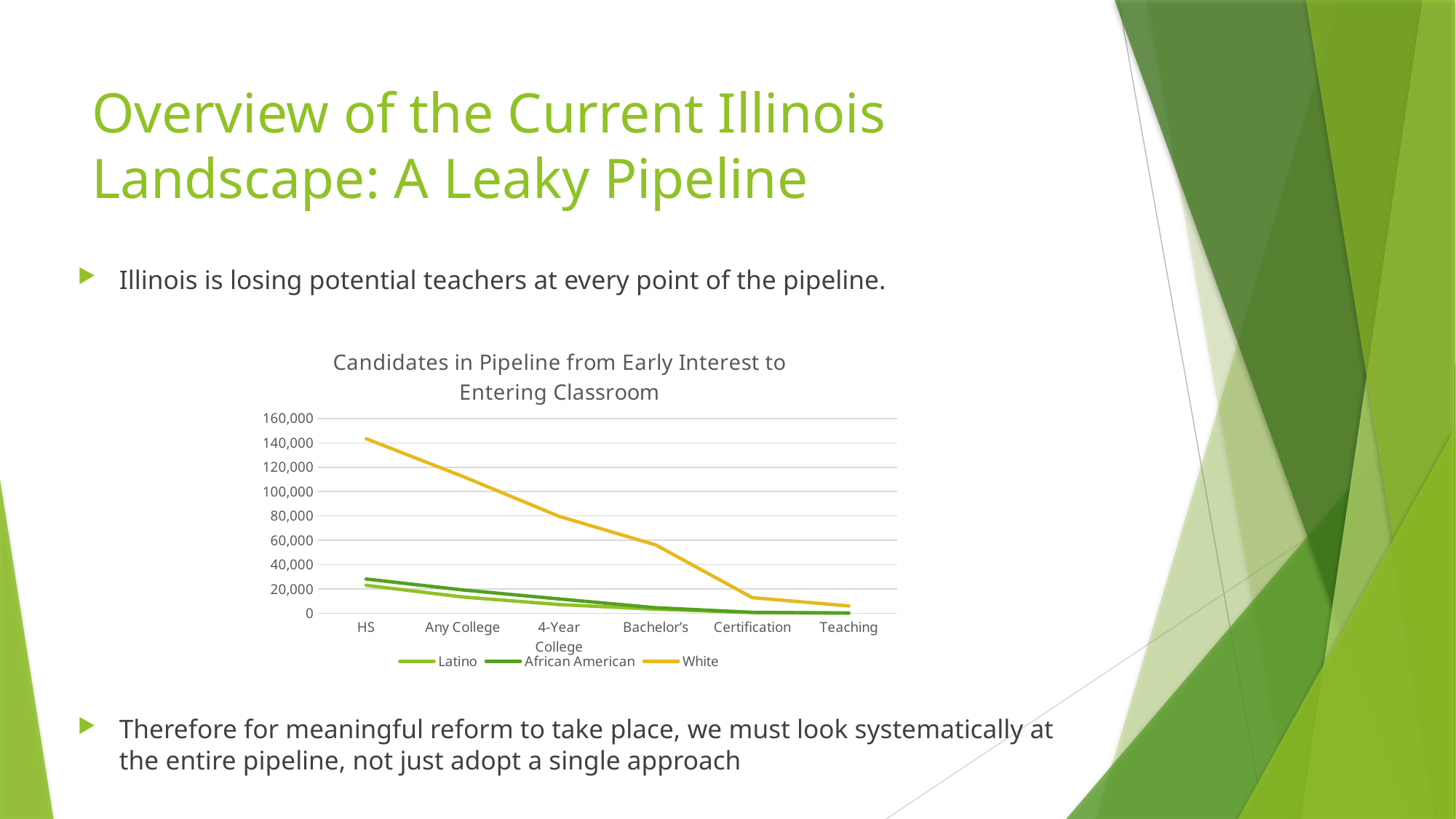
Is the value for White at Any College greater or less than 100,000? greater How many series does the legend list? 3 Is the value for White at HS greater or less than 120,000? greater At which stage is the White series at its lowest? Teaching What kind of chart is shown on the slide? line chart Do the values for the White series rise or fall from HS to Teaching? fall How many pipeline stages are shown on the x axis? 6 Is the value for White at Certification greater or less than 20,000? less At the HS stage, which is larger: the African American value or the Latino value? African American What is the title of the chart? Candidates in Pipeline from Early Interest to Entering Classroom Which series has the highest value at the HS stage? White